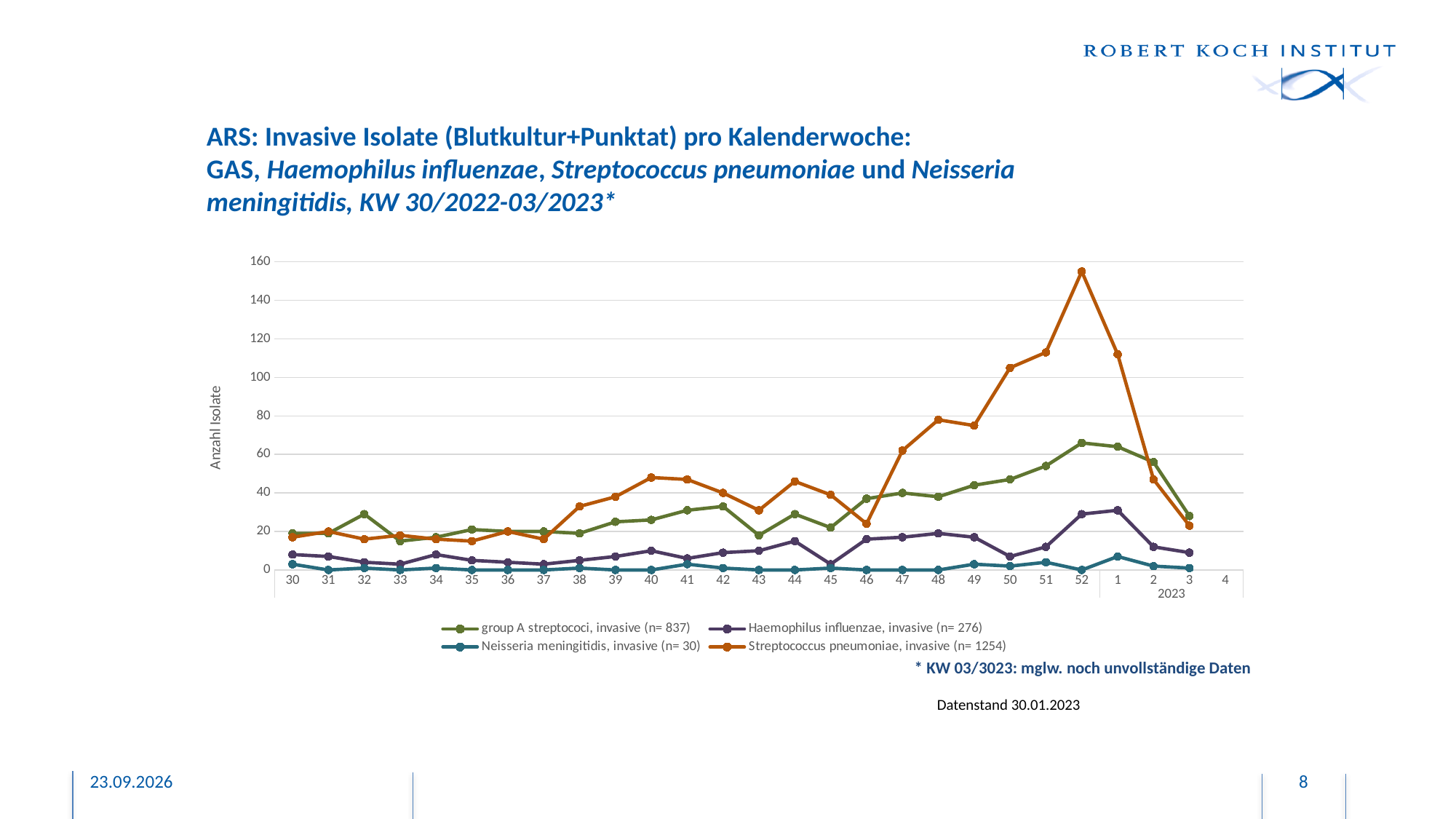
In week 46, which is larger: the value for group A streptococci or for Streptococcus pneumoniae? group A streptococci Which series has the lowest values across the whole chart? Neisseria meningitidis, invasive (n= 30) Which series reaches the highest value in the chart? Streptococcus pneumoniae, invasive (n= 1254) What is the label of the y axis? Anzahl Isolate Is the value for Neisseria meningitidis in week 1 (2023) greater or less than 20? less What kind of chart is shown on the slide? line chart Does the Streptococcus pneumoniae series rise or fall from week 46 to week 52? rise Is the value for Streptococcus pneumoniae in week 52 greater or less than 140? greater How many series does the legend list? 4 In which calendar week does the Streptococcus pneumoniae series reach its peak? 52 Is the value for group A streptococci in week 52 greater or less than 60? greater